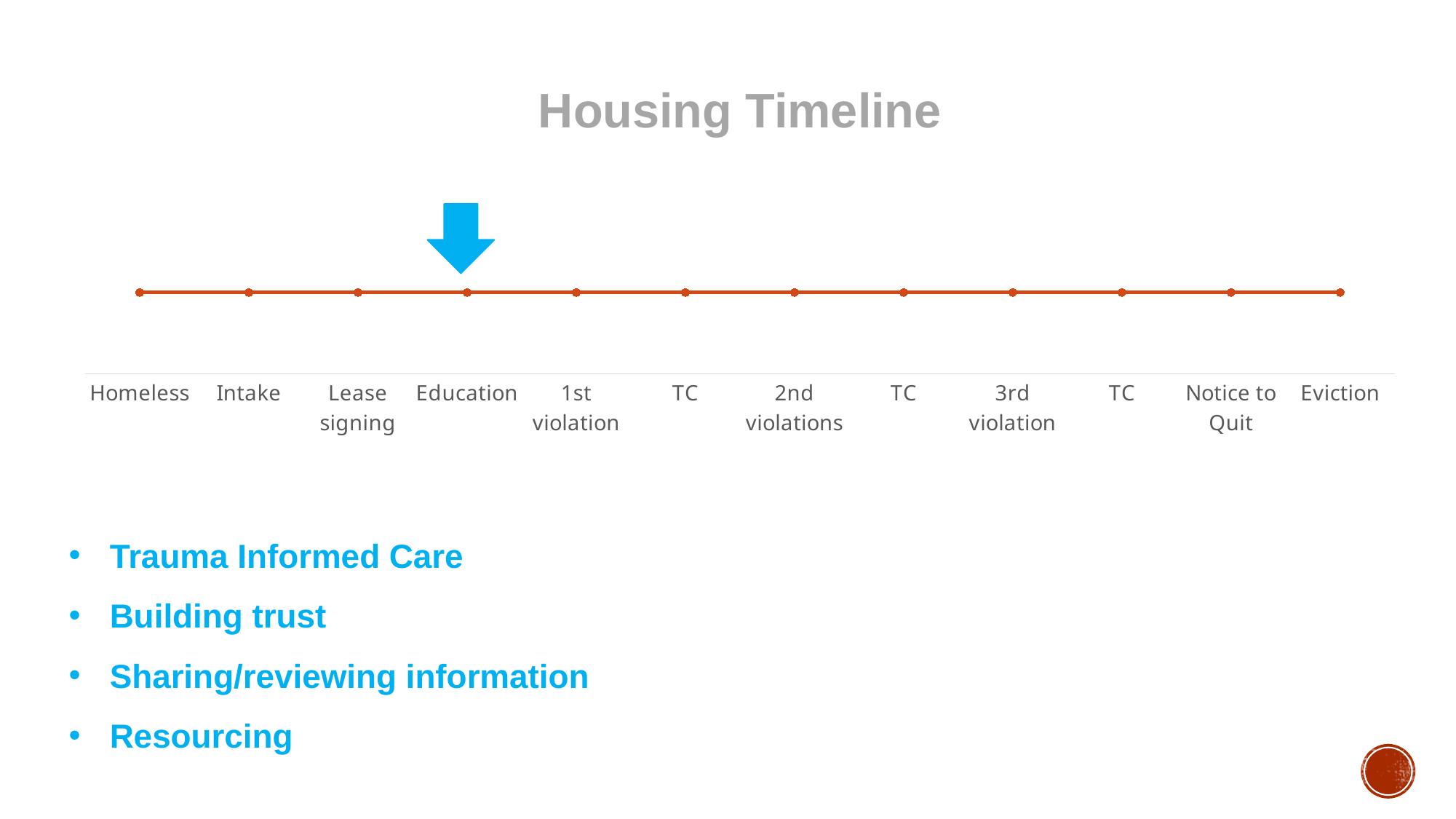
How many times does the label "TC" appear on the x axis of the Housing Timeline? 3 How many points are plotted on the Housing Timeline line? 12 What is the first category on the x axis of the Housing Timeline? Homeless Which category comes immediately after Intake on the Housing Timeline? Lease signing What is the last category on the x axis of the Housing Timeline? Eviction Which category does the blue arrow point to on the Housing Timeline? Education What is the title of the chart on the slide? Housing Timeline What kind of chart is shown on the Housing Timeline slide? Line chart Do the values on the Housing Timeline rise, fall, or stay flat from Homeless to Eviction? Stay flat Which category comes immediately before Eviction on the Housing Timeline? Notice to Quit